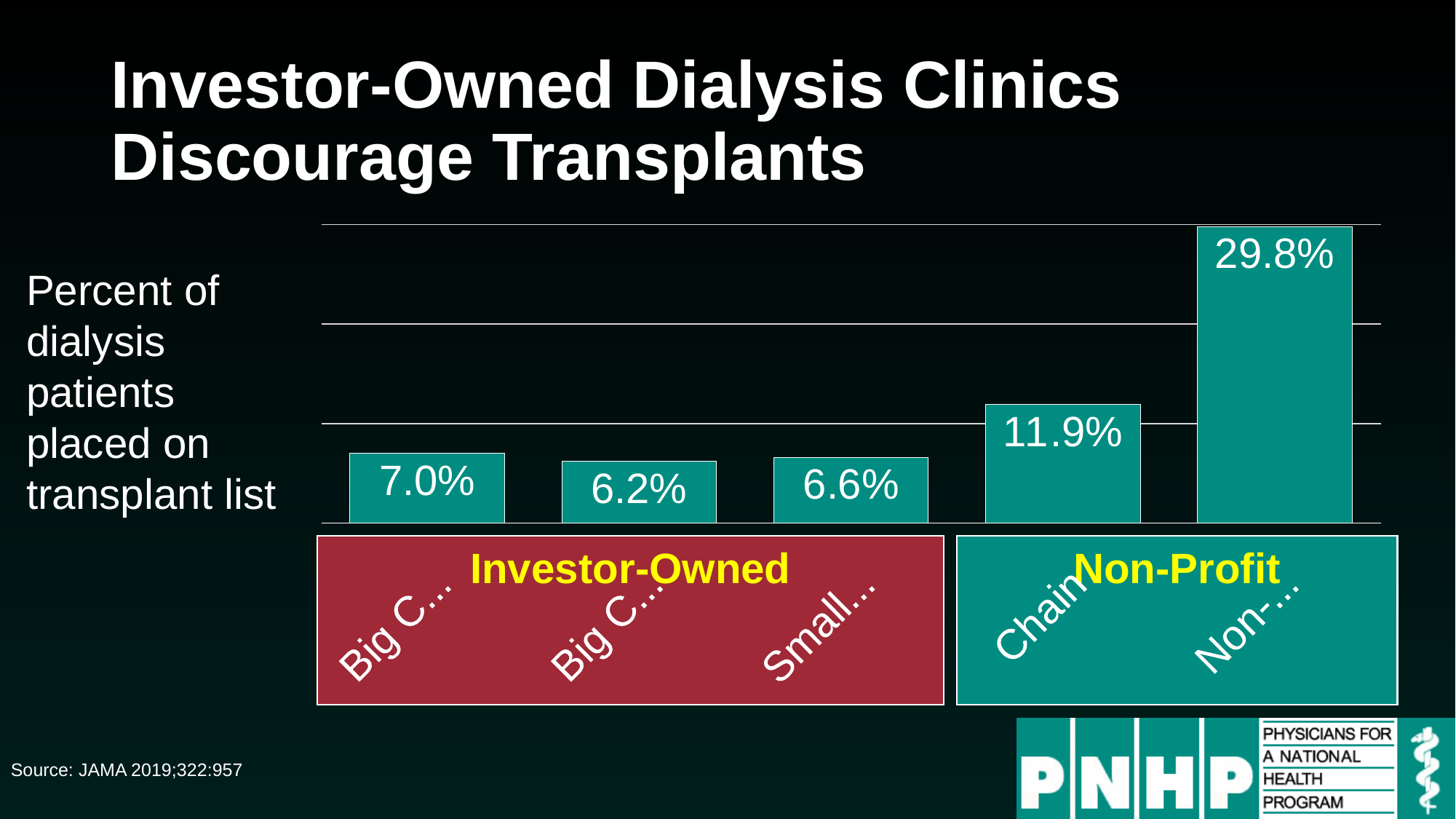
What is the difference between the first bar (7.0%) and the second bar (6.2%) in the Investor-Owned group? 0.8% What is the value for the Chain category in the Non-Profit group? 11.9% What does the text to the left of the chart say the bars measure? Percent of dialysis patients placed on transplant list What are the two group labels shown beneath the bars? Investor-Owned and Non-Profit What is the lowest value shown in the chart? 6.2% What is the highest value shown in the chart? 29.8% What kind of chart is shown on the slide? bar chart What is the value of the third bar from the left (the last bar in the Investor-Owned group)? 6.6% How many bars belong to the Investor-Owned group? 3 What is the difference between the two bars in the Non-Profit group (29.8% and 11.9%)? 17.9% Which is larger: the Chain bar in the Non-Profit group or the first bar in the Investor-Owned group? Chain How many bars are plotted in the chart? 5